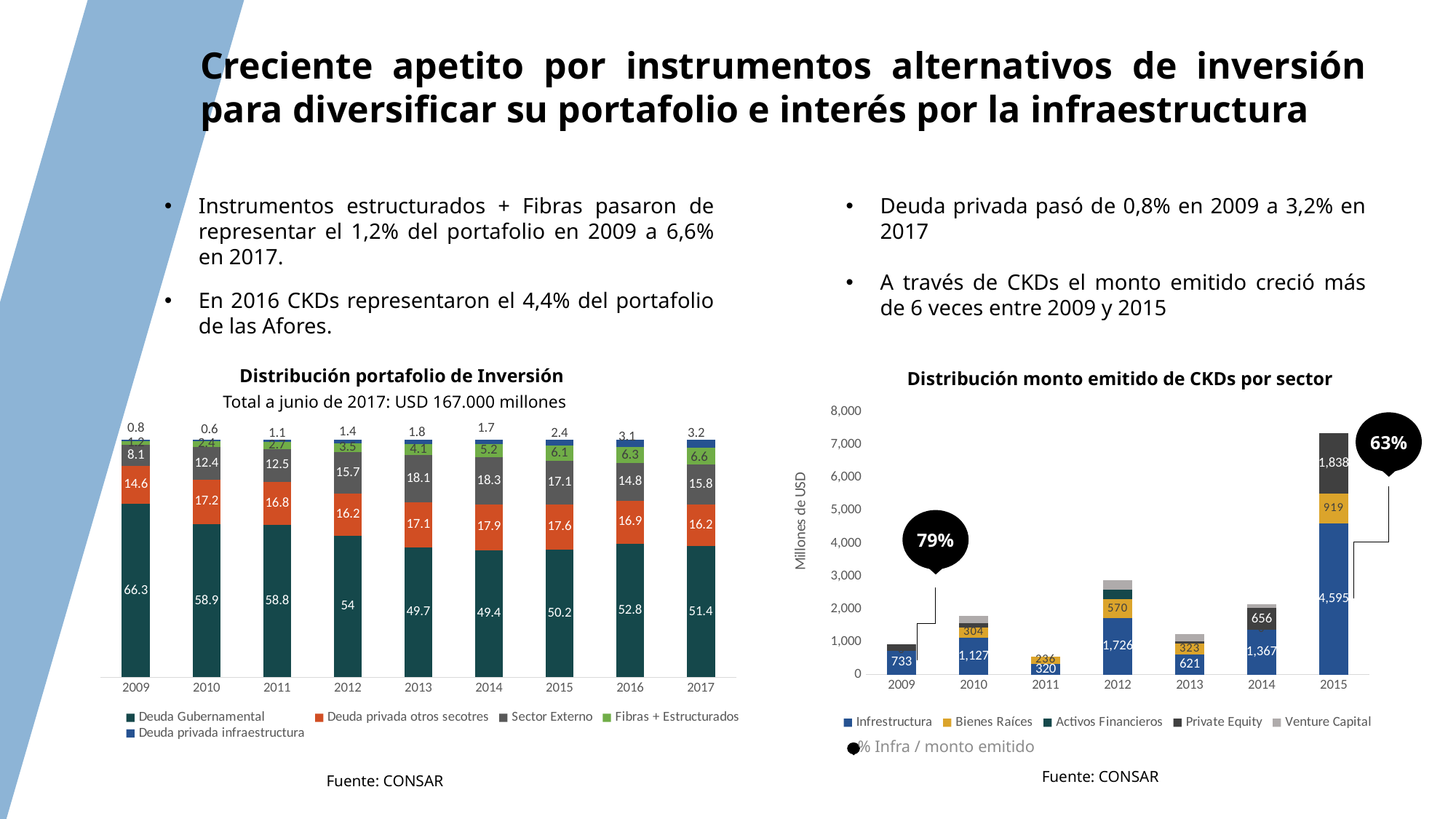
In the chart 'Distribución monto emitido de CKDs por sector', which year has the lowest Infrestructura value? 2011 In the chart 'Distribución portafolio de Inversión', what is the value for Fibras + Estructurados in 2017? 6.6 What kind of chart is 'Distribución monto emitido de CKDs por sector'? stacked bar chart In the chart 'Distribución monto emitido de CKDs por sector', is the Infrestructura value for 2012 larger than the Infrestructura value for 2014? Yes, 2012 (1,726) is larger than 2014 (1,367) In the chart 'Distribución monto emitido de CKDs por sector', is the total height of the 2015 bar greater or less than 7,000? greater In the chart 'Distribución portafolio de Inversión', which year has the highest value for Deuda Gubernamental? 2009 In the chart 'Distribución monto emitido de CKDs por sector', what is the Infrestructura value for 2015? 4,595 In the chart 'Distribución portafolio de Inversión', how many years are shown on the x axis? 9 In the chart 'Distribución portafolio de Inversión', what is the difference between the Sector Externo values for 2014 and 2009? 10.2 In the chart 'Distribución portafolio de Inversión', what is the value for Deuda Gubernamental in 2009? 66.3 In the chart 'Distribución portafolio de Inversión', how many series does the legend list? 5 In the chart 'Distribución portafolio de Inversión', do the Fibras + Estructurados values rise or fall from 2009 to 2017? rise